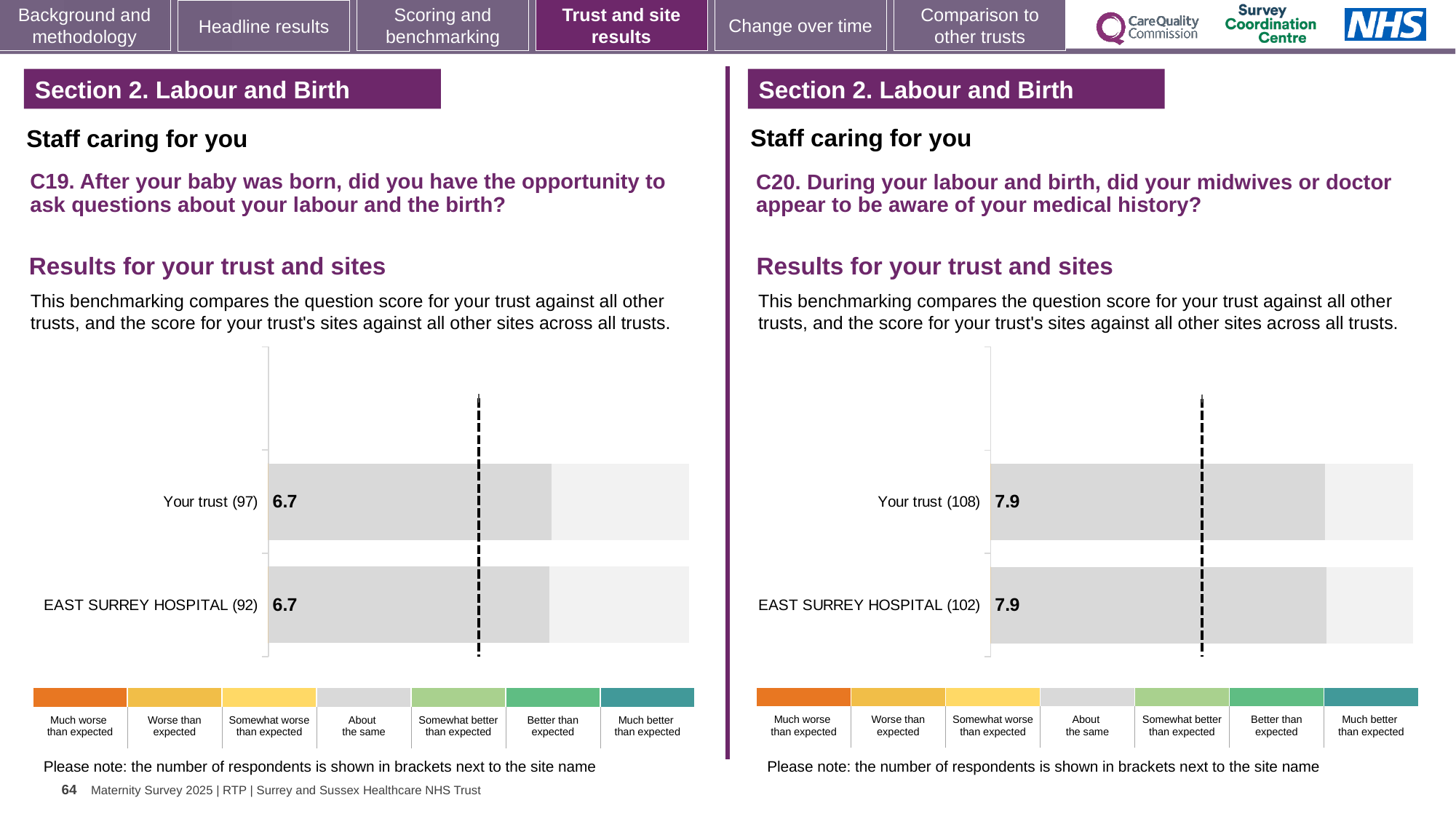
Is the score for Your trust in the C20 chart on the right greater or less than the score for Your trust in the C19 chart on the left? greater In the C19 chart on the left, what is the score for EAST SURREY HOSPITAL? 6.7 In the C19 chart on the left, how many respondents are shown in brackets next to EAST SURREY HOSPITAL? 92 In the C19 chart on the left, what is the score for Your trust? 6.7 In the C20 chart on the right, what is the score for Your trust? 7.9 How many bars are plotted in the C19 chart on the left? 2 In the C19 chart on the left, what is the difference between the score for Your trust and the score for EAST SURREY HOSPITAL? 0 In the C20 chart on the right, what is the difference between the score for Your trust and the score for EAST SURREY HOSPITAL? 0 How many bars are plotted in the C20 chart on the right? 2 What kind of chart is used for the C19 results on the left? Bar chart In the C20 chart on the right, how many respondents are shown in brackets next to Your trust? 108 In the C20 chart on the right, what is the score for EAST SURREY HOSPITAL? 7.9